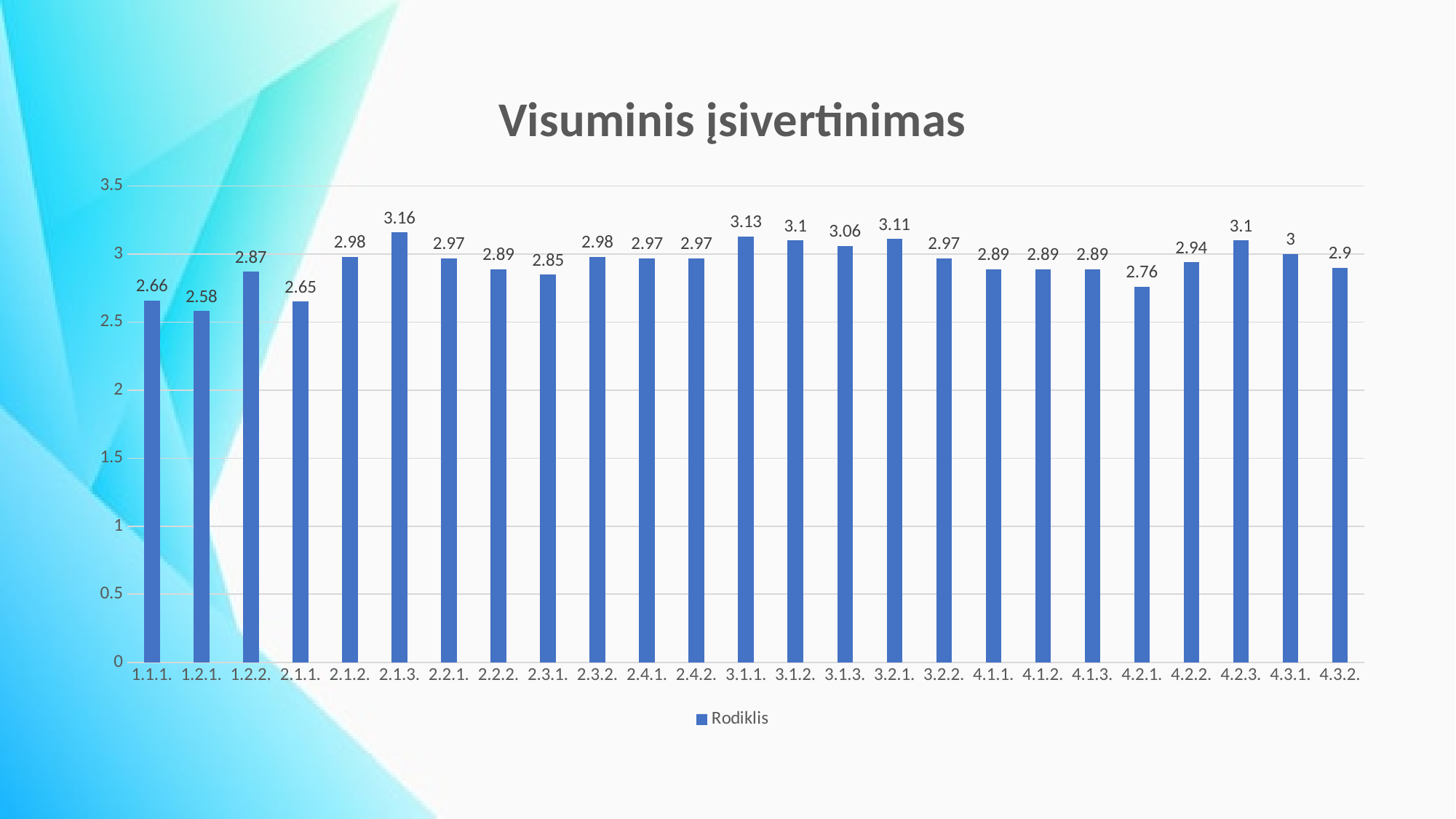
What is the value for 4.2.1.? 2.76 What is the value for 2.1.3.? 3.16 Which is larger, the value for 3.1.1. or the value for 3.2.1.? 3.1.1. How many series does the legend list? 1 Is the value for 1.1.1. greater or less than 3? less How many categories are shown on the x axis? 25 Which category has the lowest value? 1.2.1. What kind of chart is shown? bar chart What is the difference between the values for 2.1.3. and 1.2.1.? 0.58 What is the title of the chart? Visuminis įsivertinimas Which category has the highest value? 2.1.3. What is the value for 4.3.1.? 3